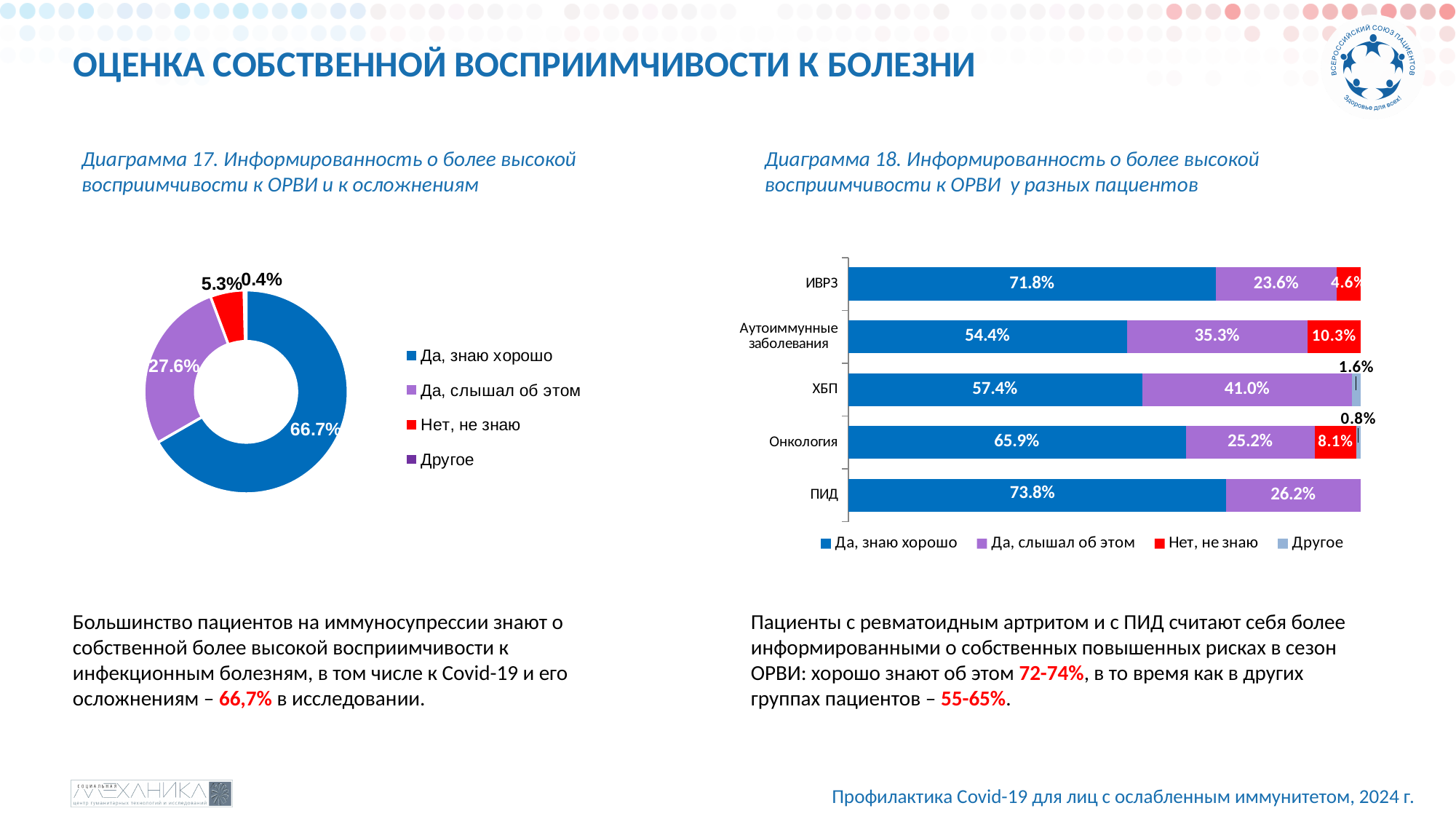
In Диаграмма 18, which patient group has the lowest value for "Да, знаю хорошо"? Аутоиммунные заболевания In Диаграмма 17, how many categories does the legend list? 4 In Диаграмма 18, what is the value of "Да, знаю хорошо" for ПИД? 73.8% In Диаграмма 17, what share of respondents answered "Да, знаю хорошо"? 66.7% In Диаграмма 18, what is the value of "Нет, не знаю" for Аутоиммунные заболевания? 10.3% In Диаграмма 18, which is larger: the "Нет, не знаю" value for Онкология or for ИВРЗ? Онкология In Диаграмма 17, which category has the smallest share? Другое In Диаграмма 18, which patient group has the highest value for "Да, знаю хорошо"? ПИД In Диаграмма 17, what share of respondents answered "Нет, не знаю"? 5.3% In Диаграмма 18, how many series does the legend list? 4 What kind of chart is Диаграмма 17? Doughnut chart In Диаграмма 18, what is the difference between the "Да, слышал об этом" values for ХБП and ИВРЗ? 17.4%